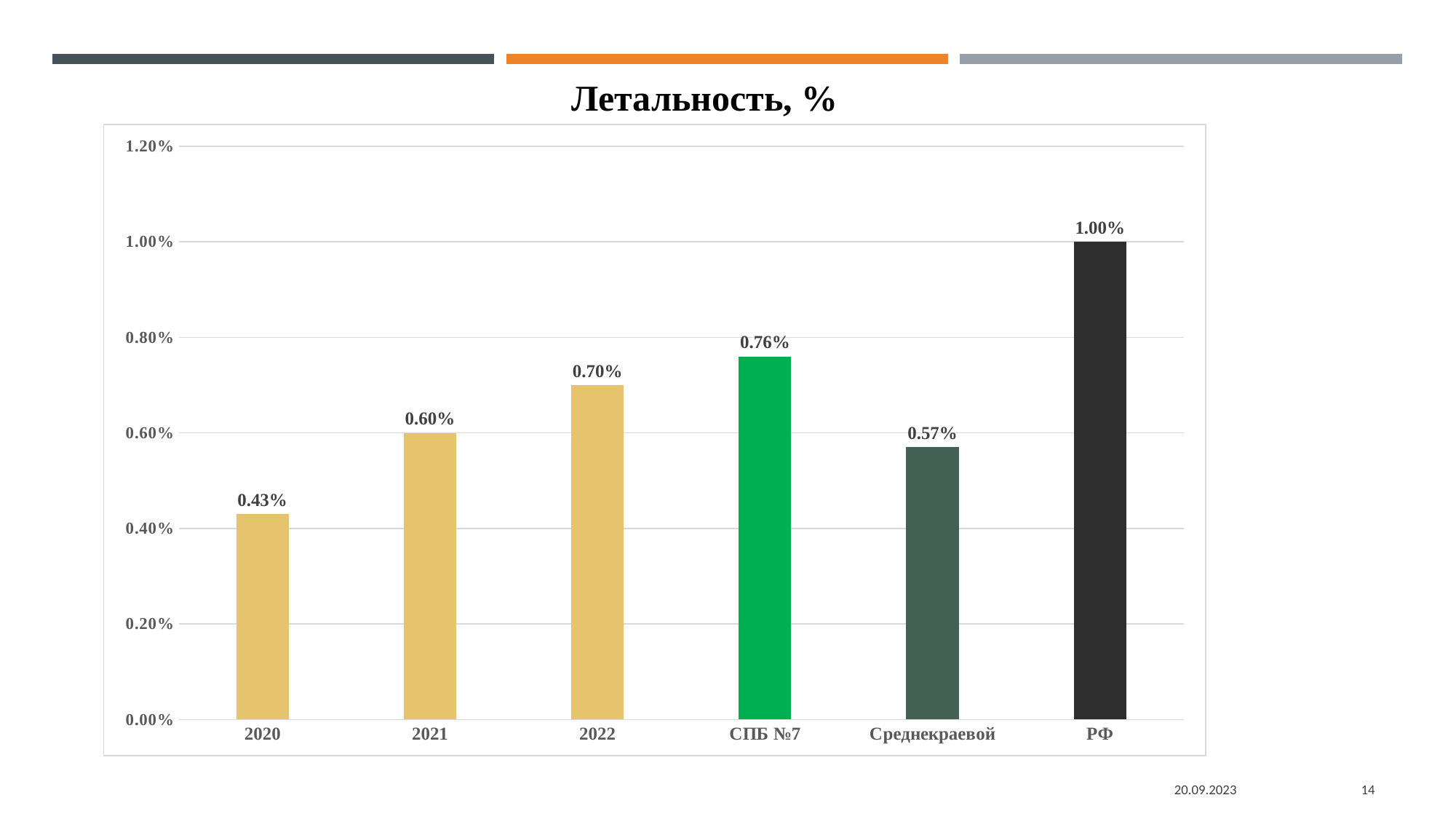
How many bars are shown in the chart? 6 What is the value for Среднекраевой? 0.57% Which category has the lowest value? 2020 What is the difference between the values for РФ and СПБ №7? 0.24% What kind of chart is shown on the slide? Bar chart What is the value for 2020? 0.43% What is the value for СПБ №7? 0.76% Which is larger, the value for СПБ №7 or the value for Среднекраевой? СПБ №7 What is the title of the chart? Летальность, % Do the values rise or fall from 2020 to 2022? Rise What is the difference between the values for 2022 and 2021? 0.10% Which category has the highest value? РФ